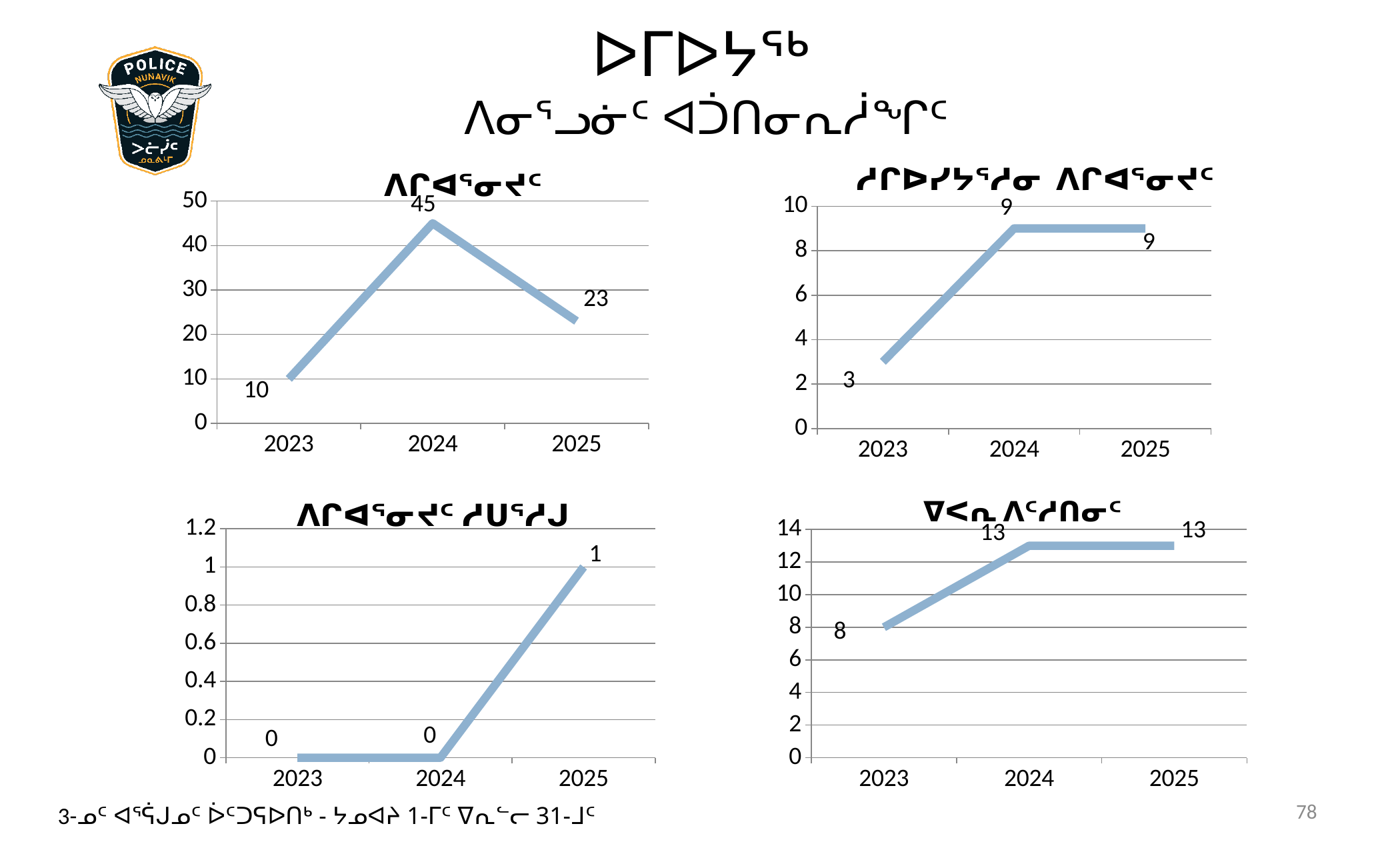
In the top-left chart, what is the difference between the 2024 and 2025 values? 22 What kind of chart is the bottom-right chart? line chart In the top-right chart, is the value for 2024 larger or smaller than the value for 2023? larger In the bottom-right chart, what is the value for 2023? 8 How many charts are shown on the slide? 4 In the top-right chart, how many data points are plotted? 3 In the top-right chart, what is the value for 2023? 3 In the bottom-left chart, what is the value for 2025? 1 In the top-left chart, what is the value for 2024? 45 In the bottom-left chart, what is the value for 2023? 0 In the bottom-right chart, what is the difference between the 2024 and 2023 values? 5 In the top-left chart, which year has the lowest value? 2023